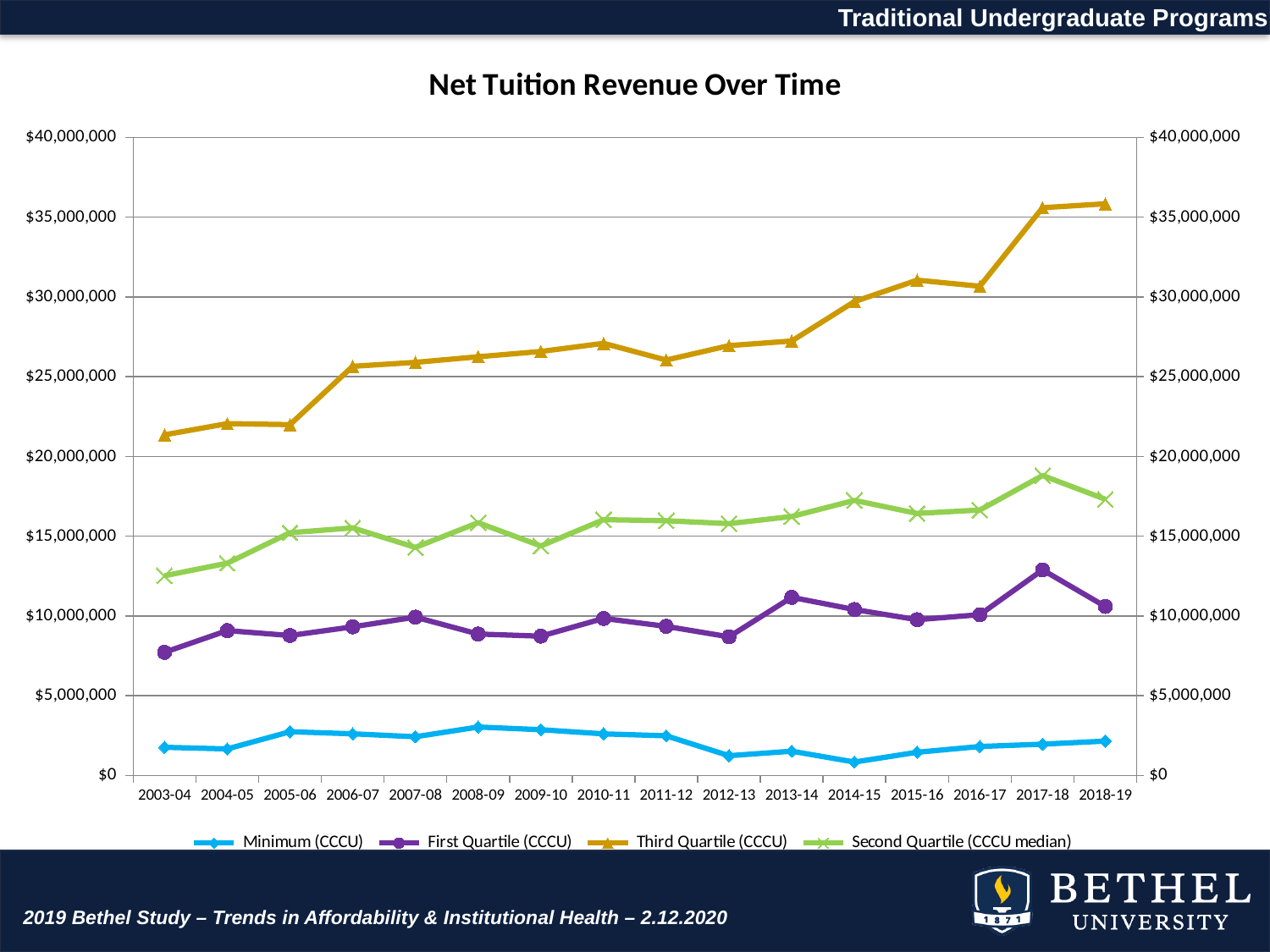
Which series is drawn with a gold line and triangle markers? Third Quartile (CCCU) Is the value for Minimum (CCCU) in 2014-15 greater or less than $5,000,000? less What kind of chart is shown on the slide? line chart How many series does the legend list? 4 Which is larger in 2010-11, the Third Quartile (CCCU) value or the Second Quartile (CCCU median) value? Third Quartile (CCCU) Is the value for First Quartile (CCCU) in 2003-04 greater or less than $10,000,000? less In which year does the Second Quartile (CCCU median) series reach its highest value? 2017-18 Is the value for Third Quartile (CCCU) in 2017-18 greater or less than $35,000,000? greater How many academic years are plotted along the x axis? 16 In which year does the Minimum (CCCU) series reach its lowest value? 2014-15 What is the title of the chart? Net Tuition Revenue Over Time